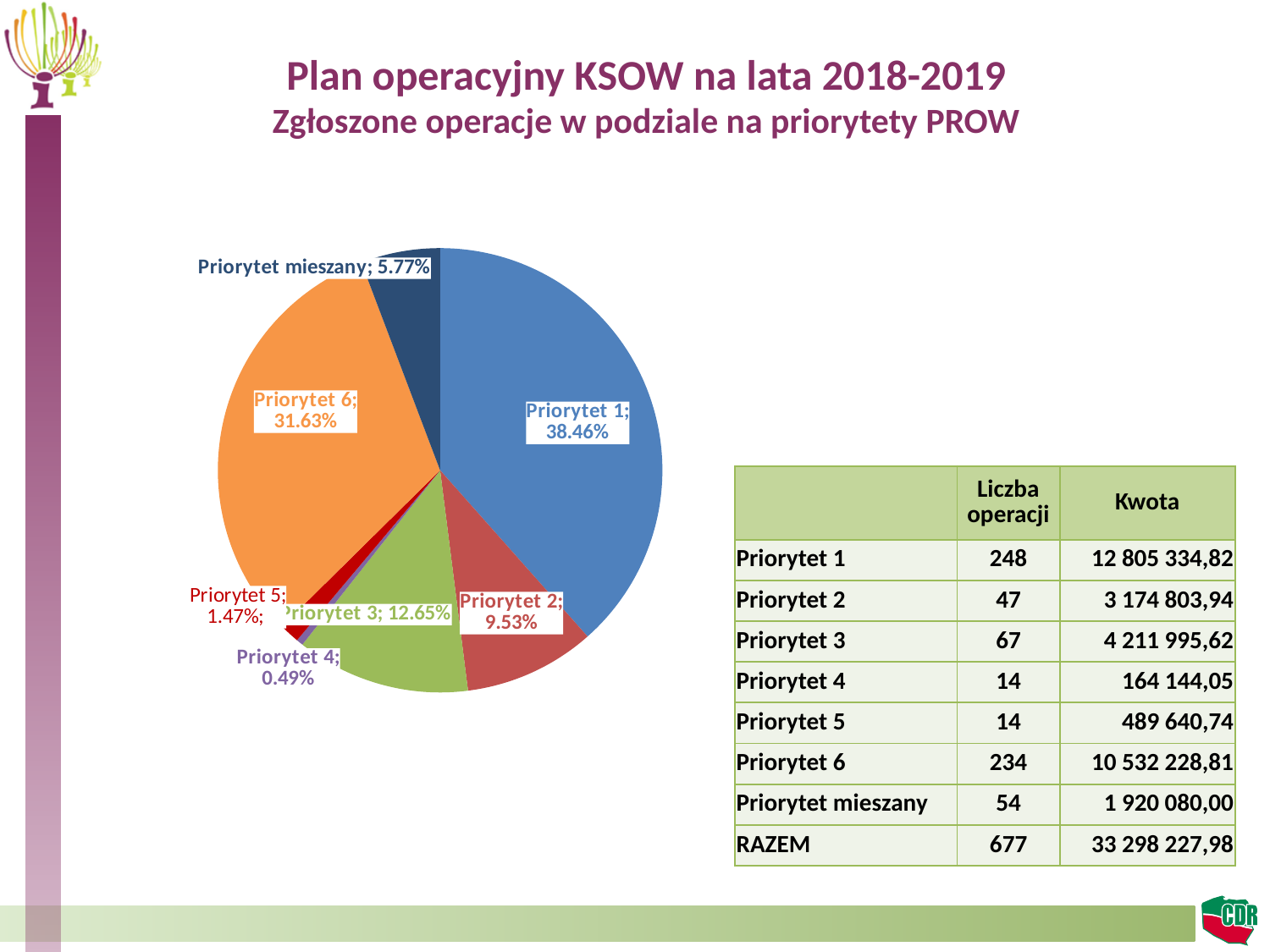
What is the value shown for Priorytet mieszany in the pie chart? 5.77% What share of the pie does Priorytet 6 have? 31.63% What colour is the Priorytet 6 slice in the pie chart? orange What is the value shown for Priorytet 3 in the pie chart? 12.65% What share of the pie does Priorytet 1 have? 38.46% What is the value shown for Priorytet 5 in the pie chart? 1.47% What kind of chart is shown on the slide? pie chart Which slice of the pie chart is the smallest? Priorytet 4 How many slices does the pie chart have? 7 Which is larger in the pie chart, Priorytet 2 or Priorytet 3? Priorytet 3 What is the difference in percentage points between Priorytet 1 and Priorytet 6 in the pie chart? 6.83 Which slice of the pie chart is the largest? Priorytet 1